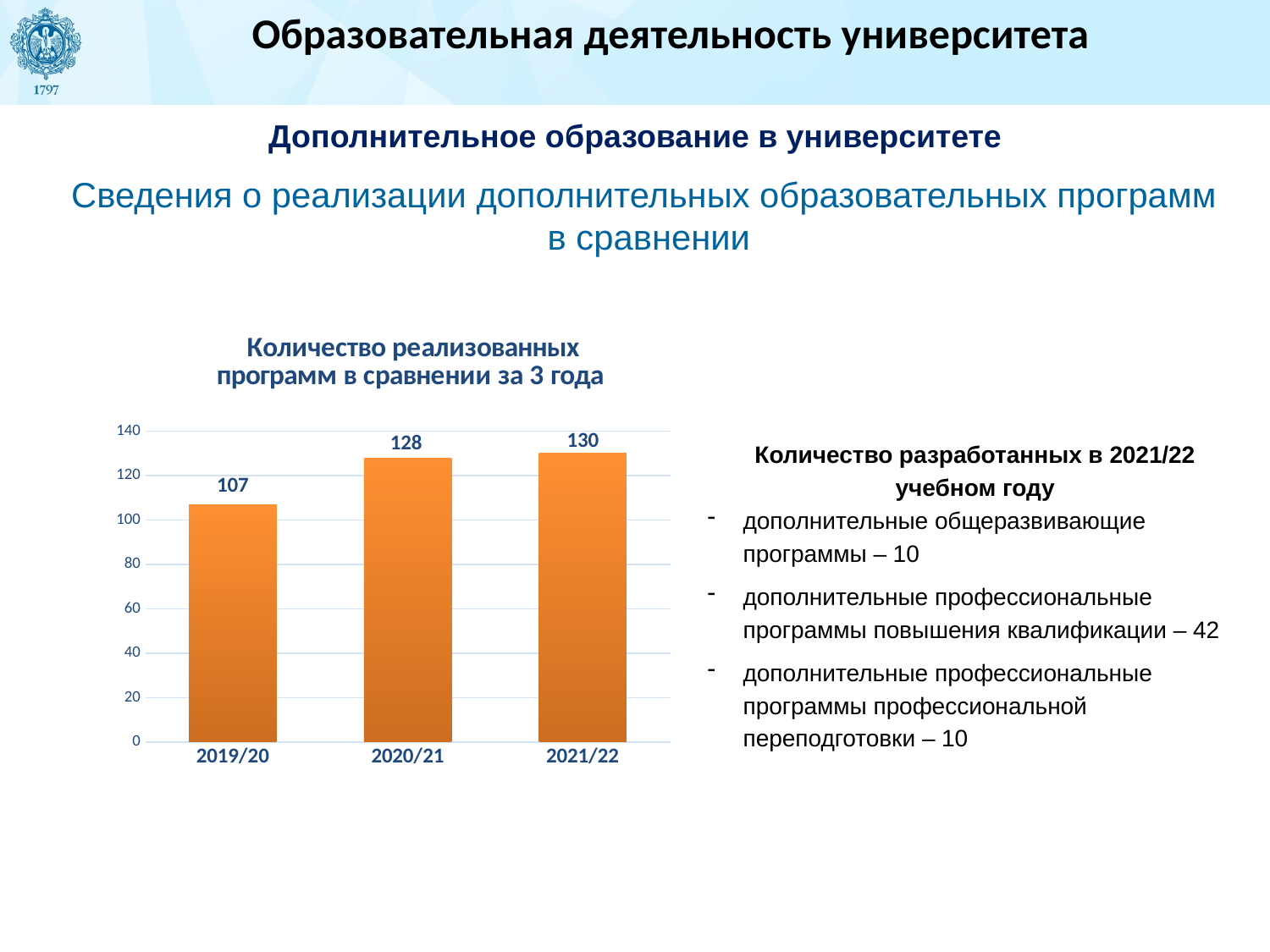
What is the value for 2019/20? 107 Which year has the highest value? 2021/22 Do the values rise or fall from 2019/20 to 2021/22? rise What is the difference between the values for 2020/21 and 2019/20? 21 Is the value for 2019/20 greater or less than 100? greater What is the value for 2020/21? 128 What kind of chart is shown on the slide? bar chart What is the value for 2021/22? 130 What is the difference between the values for 2021/22 and 2019/20? 23 Which is larger, the value for 2019/20 or the value for 2020/21? 2020/21 How many years are shown on the chart? 3 Which year has the lowest value? 2019/20